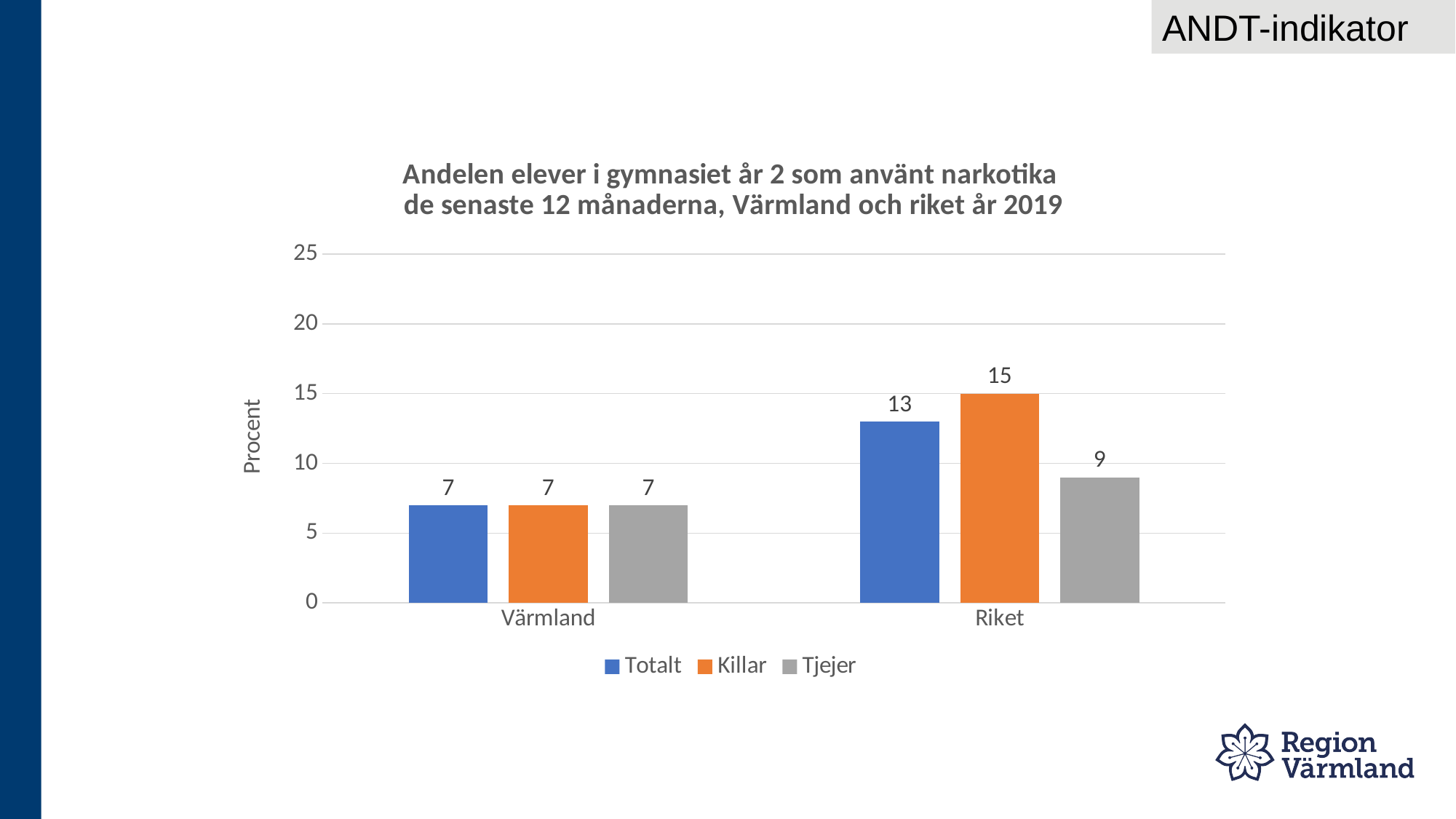
What is the difference between the Totalt value for Riket and the Tjejer value for Riket? 4 What is the value for Tjejer in Värmland? 7 What is the value for Totalt in Riket? 13 What is the difference between the Killar value for Riket and the Killar value for Värmland? 8 How many categories are shown on the x axis? 2 How many series does the legend list? 3 Which series has the highest value in Riket? Killar Which is larger, the Tjejer value for Riket or the Tjejer value for Värmland? Riket What is the value for Killar in Riket? 15 Which series has the lowest value in Riket? Tjejer What kind of chart is shown on the slide? Bar chart What is the label of the y axis? Procent